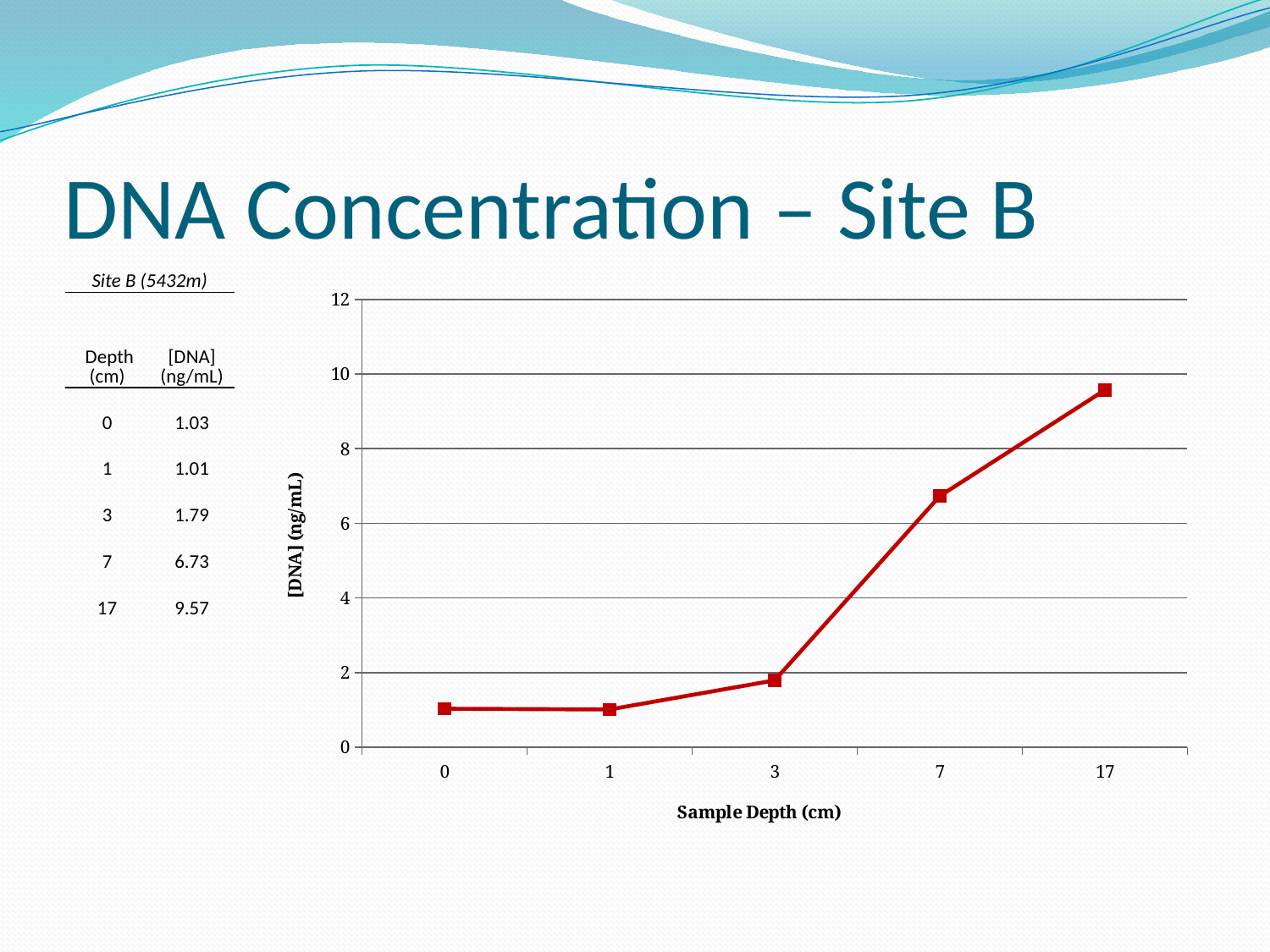
What is the difference in DNA concentration between the 17 cm and 7 cm sample depths? 2.84 How many data points are plotted on the line chart? 5 What is the DNA concentration at a sample depth of 17 cm? 9.57 What kind of chart is shown on the slide? line chart At which sample depth is the DNA concentration lowest? 1 At which sample depth is the DNA concentration highest? 17 What is the label of the y axis on the chart? [DNA] (ng/mL) Does the DNA concentration generally rise or fall as sample depth increases? rise What is the DNA concentration at a sample depth of 7 cm? 6.73 What is the DNA concentration at a sample depth of 0 cm? 1.03 Is the DNA concentration at a sample depth of 17 cm greater or less than 8? greater Which sample depth has a higher DNA concentration, 3 cm or 7 cm? 7